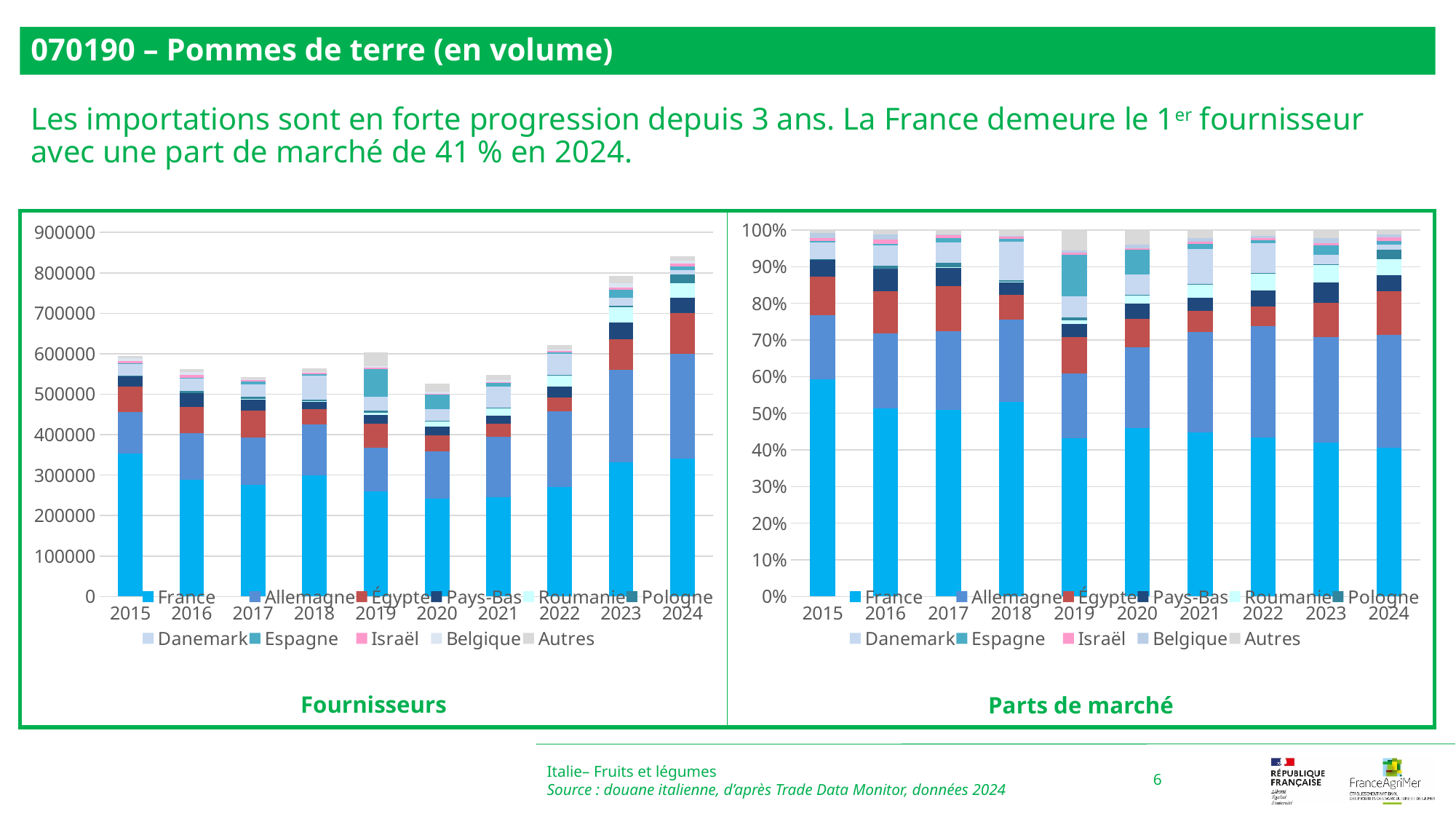
In the 'Fournisseurs' chart, which year has the highest total stacked bar? 2024 In the 'Fournisseurs' chart, is the total stacked bar for 2024 greater or less than 800000? greater What kind of chart is the 'Fournisseurs' chart on the left? Stacked bar chart In the 'Fournisseurs' chart, is the total stacked bar for 2020 greater or less than 600000? less What is the title of the chart on the right side of the slide? Parts de marché In the 'Parts de marché' chart, is France's share in 2015 greater or less than 50%? greater In the 'Parts de marché' chart, which year shows the highest share for France? 2015 How many series does the legend of the 'Parts de marché' chart list? 11 In the 'Fournisseurs' chart, is the total for 2023 larger or smaller than the total for 2022? larger How many years are shown on the x axis of the 'Fournisseurs' chart? 10